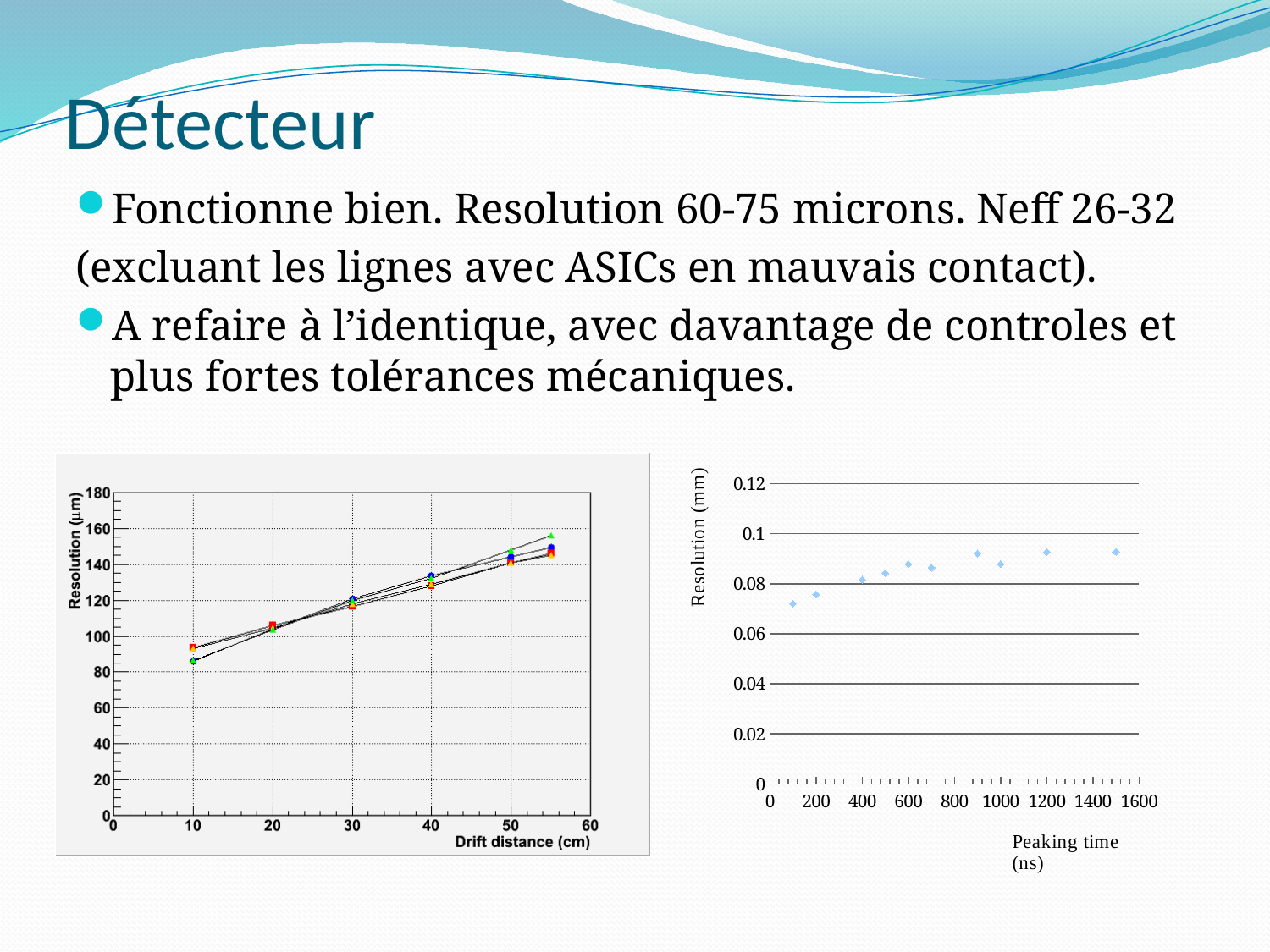
In the left-hand chart, do the resolution values rise or fall as drift distance increases? rise In the right-hand chart, is the resolution at a peaking time of 100 ns greater or less than 0.08? less In the right-hand chart, is the resolution at a peaking time of 1500 ns greater or less than 0.08? greater In the left-hand chart, at which drift distance is the resolution lowest? 10 cm In the right-hand chart, does the resolution generally rise or fall as peaking time increases? rise In the left-hand chart, is the resolution at a drift distance of 30 cm greater or less than 140? less What kind of chart is the right-hand chart (Resolution vs Peaking time)? scatter chart In the right-hand chart, what is the label of the y axis? Resolution (mm) In the left-hand chart, what is the label of the x axis? Drift distance (cm)